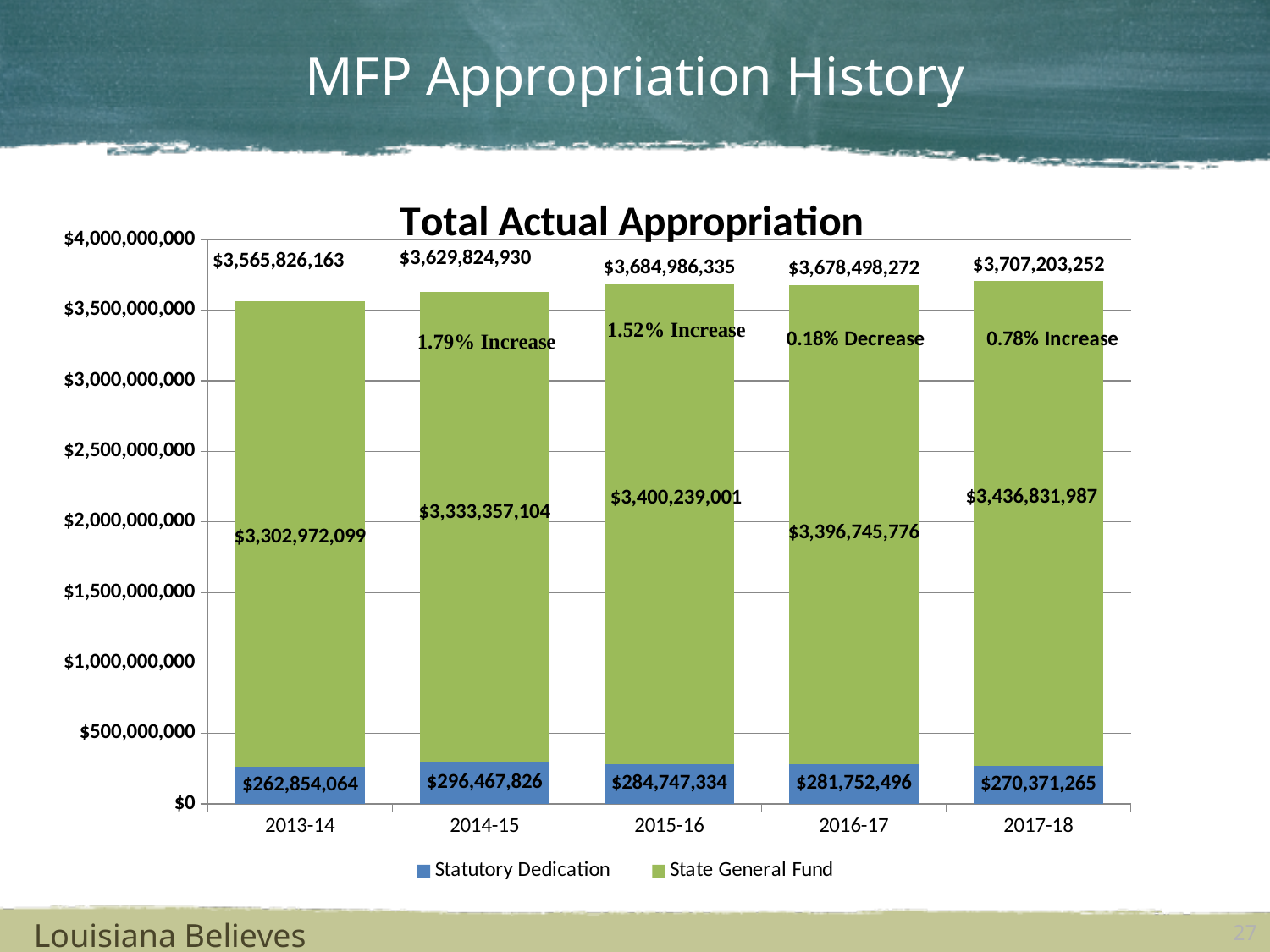
How many fiscal years are shown on the x axis? 5 Which is larger, the State General Fund value for 2015-16 or for 2016-17? 2015-16 Which year has the highest total actual appropriation? 2017-18 What percentage change is annotated for 2016-17? 0.18% Decrease What is the Statutory Dedication value for 2013-14? $262,854,064 Which year has the lowest Statutory Dedication value? 2013-14 What is the total actual appropriation for 2015-16? $3,684,986,335 How many series does the legend list? 2 Is the Statutory Dedication value for 2016-17 greater or less than $500,000,000? less What is the difference between the Statutory Dedication values for 2014-15 and 2013-14? $33,613,762 Which year has the highest Statutory Dedication value? 2014-15 What is the State General Fund value for 2017-18? $3,436,831,987